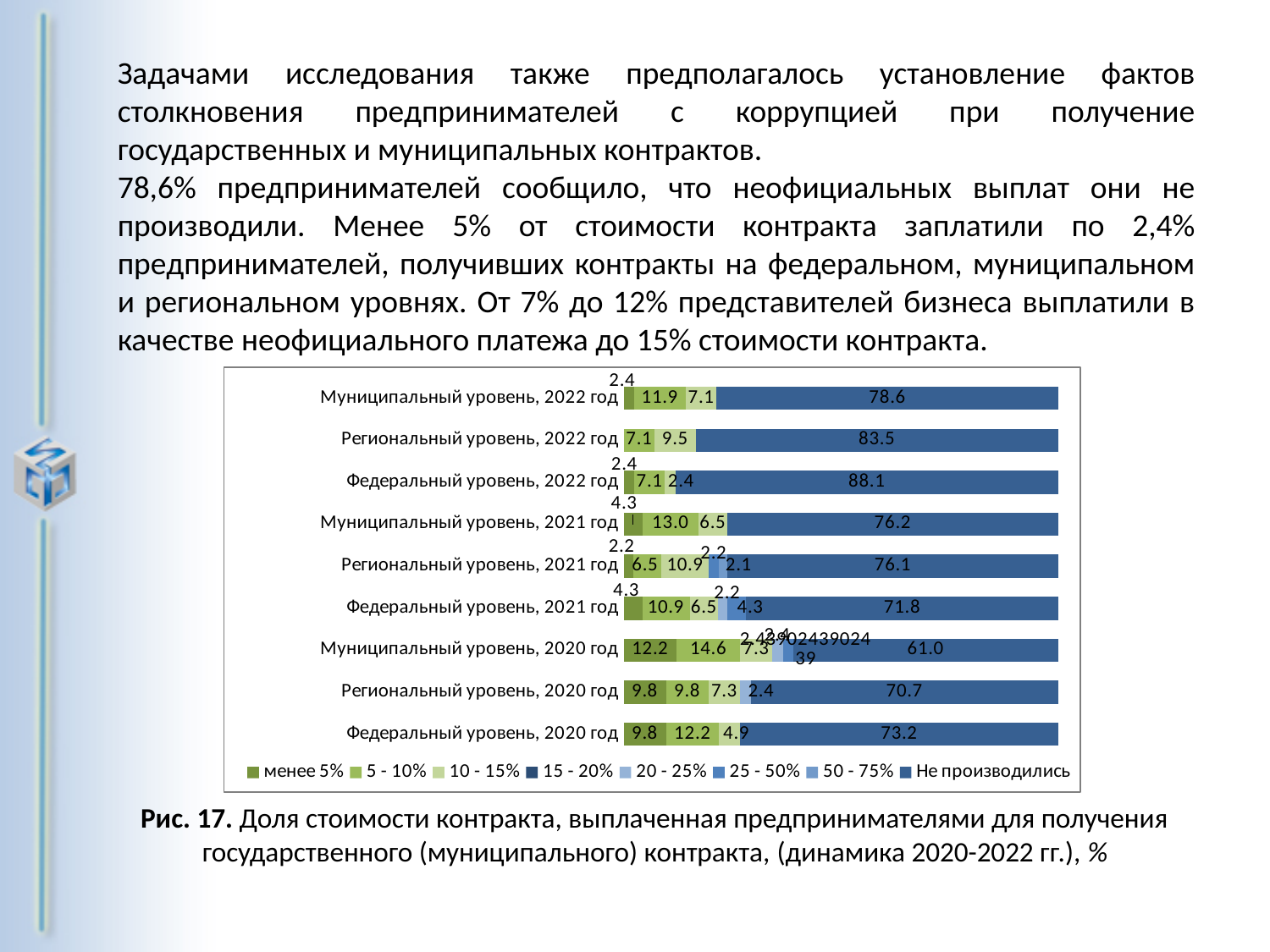
What kind of chart is shown on the slide? Stacked bar chart What is the first series listed in the chart legend? менее 5% What is the value of '5 - 10%' for 'Федеральный уровень, 2020 год'? 12.2 What is the value of '5 - 10%' for 'Муниципальный уровень, 2022 год'? 11.9 What is the value of 'Не производились' for 'Муниципальный уровень, 2022 год'? 78.6 How many series does the chart legend list? 8 Which category has the lowest value for 'Не производились'? Муниципальный уровень, 2020 год How many categories (bars) are shown in the chart? 9 Which category has the highest value for 'Не производились'? Федеральный уровень, 2022 год What is the value of 'Не производились' for 'Федеральный уровень, 2022 год'? 88.1 Which has a larger 'Не производились' value: 'Региональный уровень, 2022 год' or 'Муниципальный уровень, 2022 год'? Региональный уровень, 2022 год What is the difference between the 'Не производились' values for 'Федеральный уровень, 2022 год' and 'Муниципальный уровень, 2020 год'? 27.1